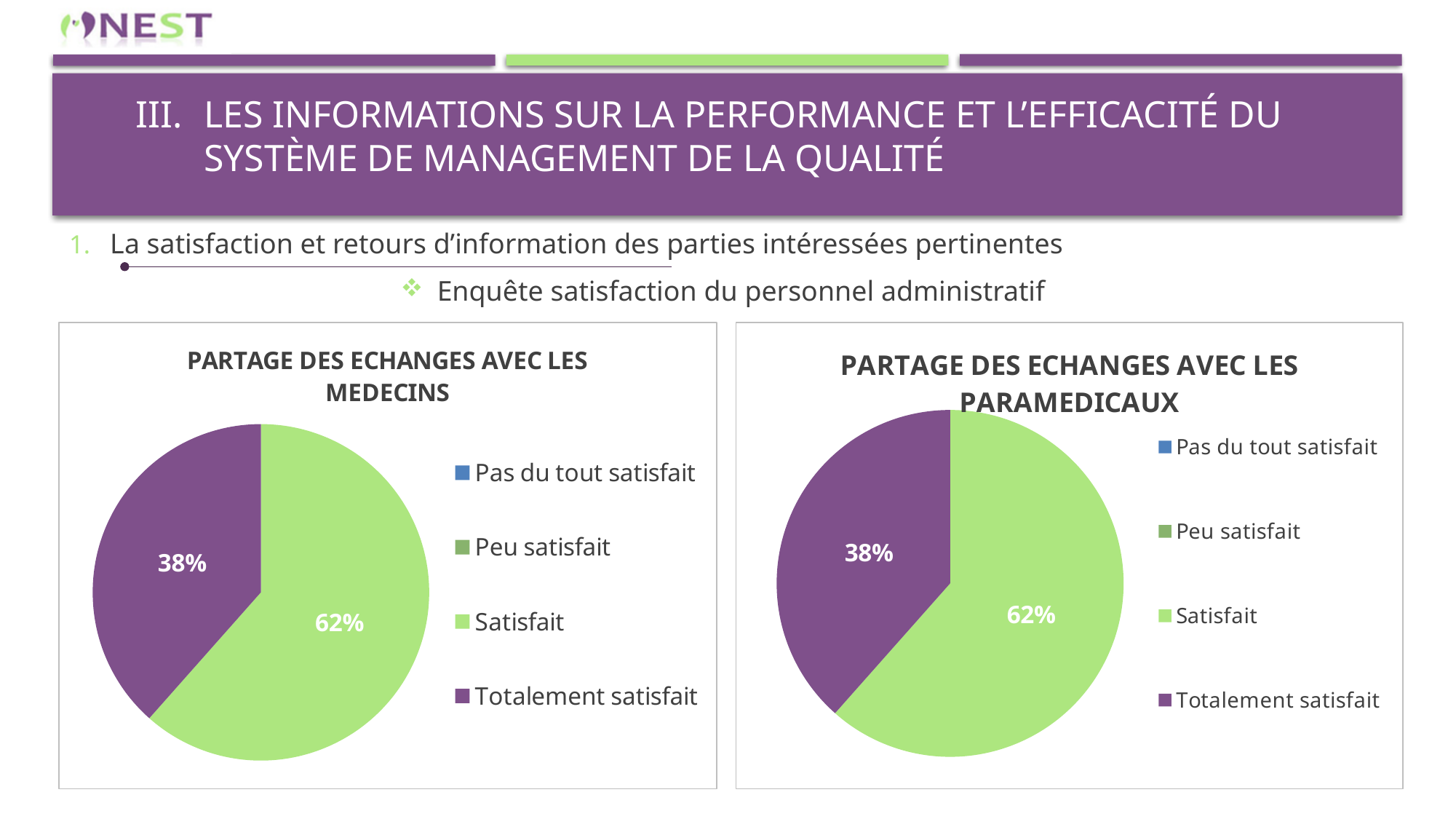
In the chart titled "PARTAGE DES ECHANGES AVEC LES PARAMEDICAUX", which labelled category has the smallest slice? Totalement satisfait In the chart titled "PARTAGE DES ECHANGES AVEC LES MEDECINS", what share is labelled for the Totalement satisfait slice? 38% In the chart titled "PARTAGE DES ECHANGES AVEC LES MEDECINS", what colour is the Totalement satisfait slice? Purple In the chart titled "PARTAGE DES ECHANGES AVEC LES MEDECINS", what share is labelled for the Satisfait slice? 62% In the chart titled "PARTAGE DES ECHANGES AVEC LES MEDECINS", what is the difference in percentage points between the Satisfait and Totalement satisfait slices? 24 percentage points In the chart titled "PARTAGE DES ECHANGES AVEC LES MEDECINS", which category has the largest slice? Satisfait What type of chart is the one titled "PARTAGE DES ECHANGES AVEC LES MEDECINS"? Pie chart In the chart titled "PARTAGE DES ECHANGES AVEC LES PARAMEDICAUX", what share is labelled for the Satisfait slice? 62% How many entries does the legend list in the chart titled "PARTAGE DES ECHANGES AVEC LES PARAMEDICAUX"? 4 In the chart titled "PARTAGE DES ECHANGES AVEC LES PARAMEDICAUX", how many slices are visible in the pie? 2 In the chart titled "PARTAGE DES ECHANGES AVEC LES PARAMEDICAUX", which is larger: Satisfait or Totalement satisfait? Satisfait In the chart titled "PARTAGE DES ECHANGES AVEC LES PARAMEDICAUX", what share is labelled for the Totalement satisfait slice? 38%